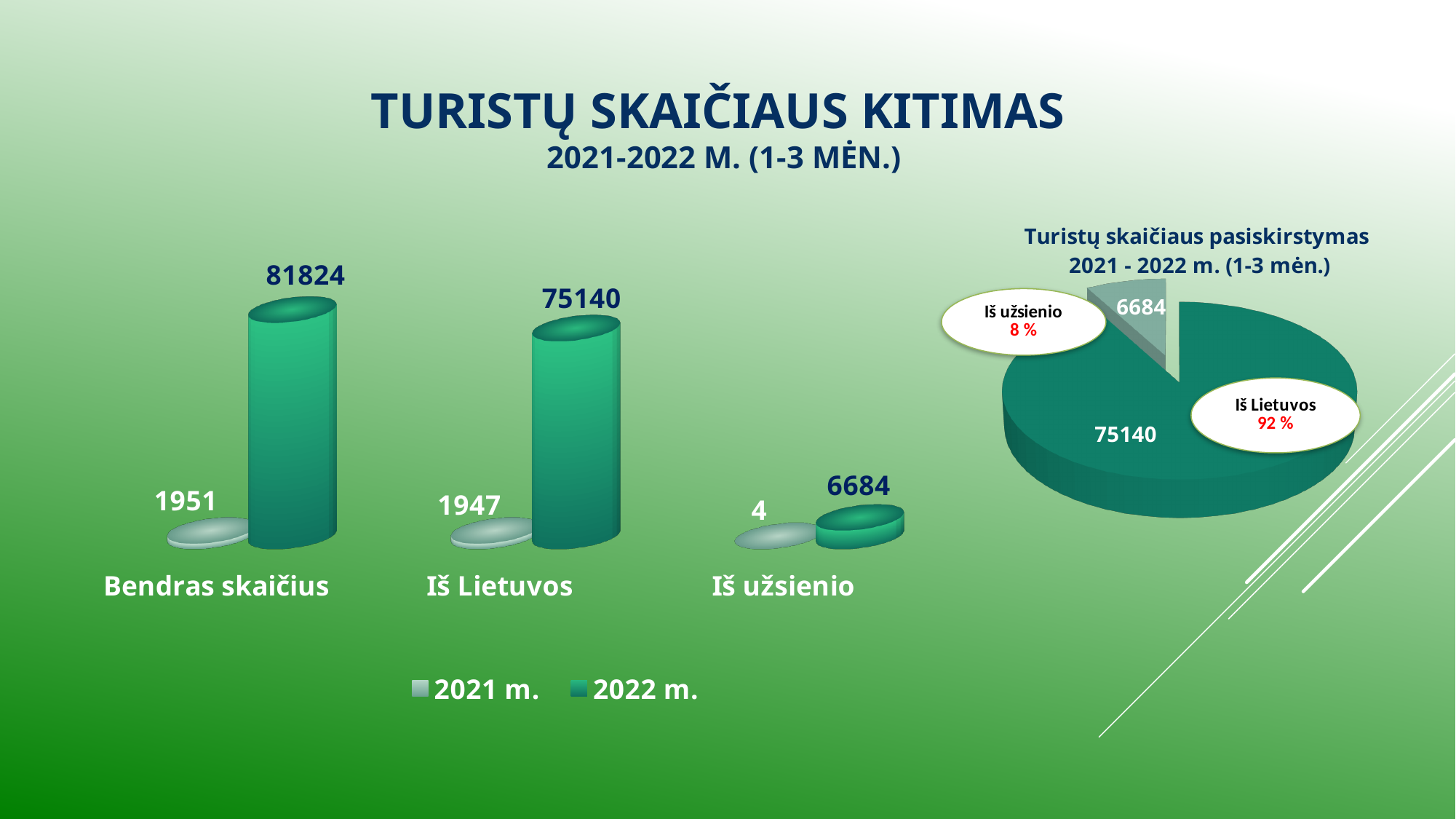
In the pie chart on the right, what is the value shown for Iš Lietuvos? 75140 In the bar chart on the left, what is the value for Iš Lietuvos in 2021 m.? 1947 How many categories are shown in the bar chart on the left? 3 In the pie chart on the right, what share does Iš užsienio have? 8 % In the bar chart on the left, what is the value for Bendras skaičius in 2022 m.? 81824 How many series does the legend of the bar chart on the left list? 2 In the bar chart on the left, which is larger: the 2022 m. value for Iš Lietuvos or the 2022 m. value for Iš užsienio? Iš Lietuvos In the bar chart on the left, what is the value for Iš užsienio in 2021 m.? 4 In the bar chart on the left, which category has the highest value for 2022 m.? Bendras skaičius In the bar chart on the left, which category has the lowest value for 2021 m.? Iš užsienio What kind of chart is the chart on the right of the slide? Pie chart In the bar chart on the left, what is the difference between the 2022 m. and 2021 m. values for Bendras skaičius? 79873